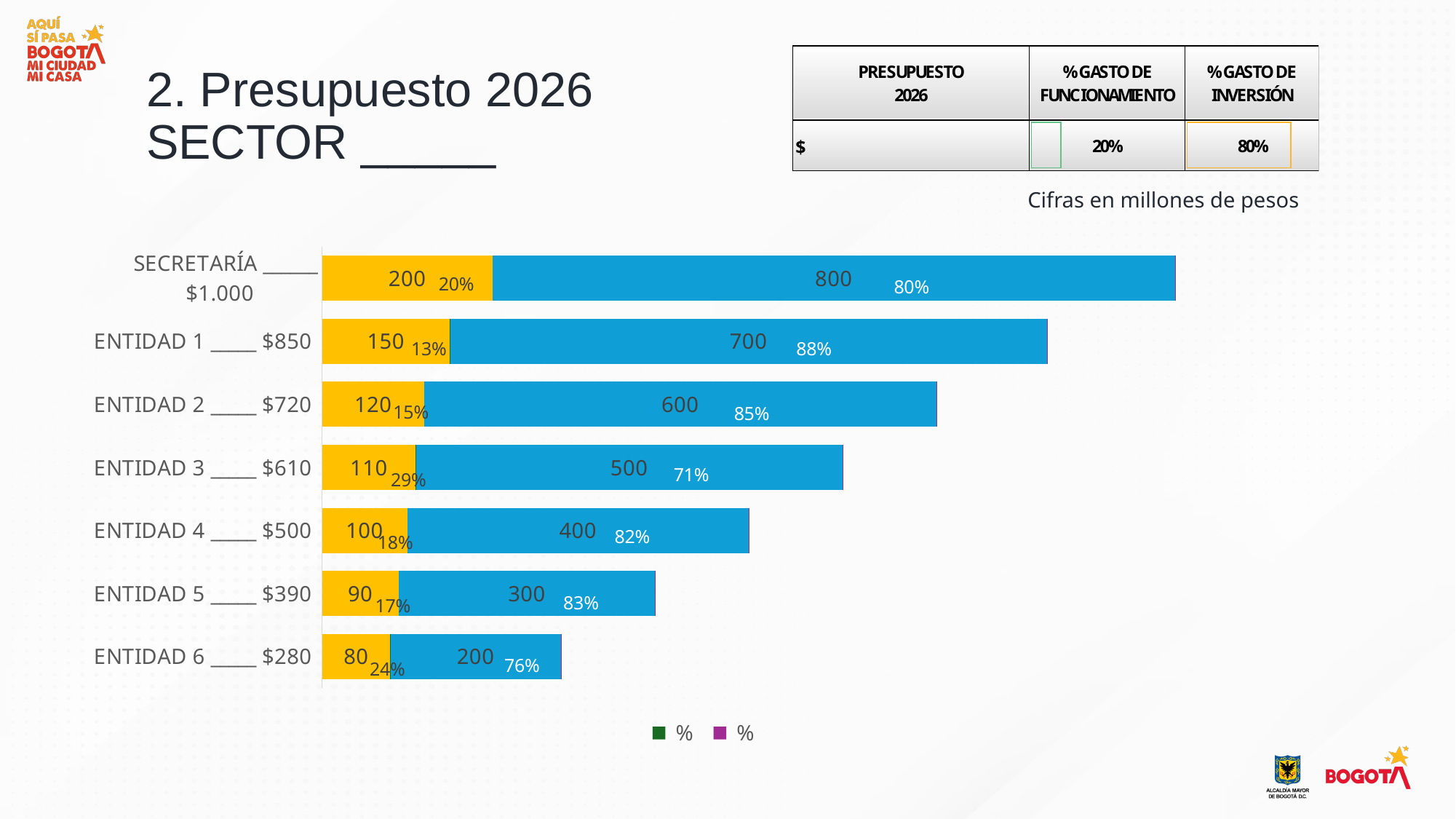
What type of chart is shown on the slide? Stacked bar chart What percentage label is shown on the yellow segment for ENTIDAD 6? 24% Do the total bar lengths rise or fall going from the top category to the bottom category? Fall What percentage label is shown on the blue segment for ENTIDAD 3? 71% Which is larger, the yellow segment of ENTIDAD 3 or the yellow segment of ENTIDAD 4? ENTIDAD 3 What is the difference between the blue segment values of ENTIDAD 1 and ENTIDAD 4? 300 What is the value of the yellow segment for ENTIDAD 5? 90 Which category has the largest blue segment? SECRETARÍA Which category has the smallest yellow segment? ENTIDAD 6 What is the value of the blue segment for ENTIDAD 2? 600 What is the total of the stacked bar for ENTIDAD 5? 390 How many categories (bars) does the chart show? 7